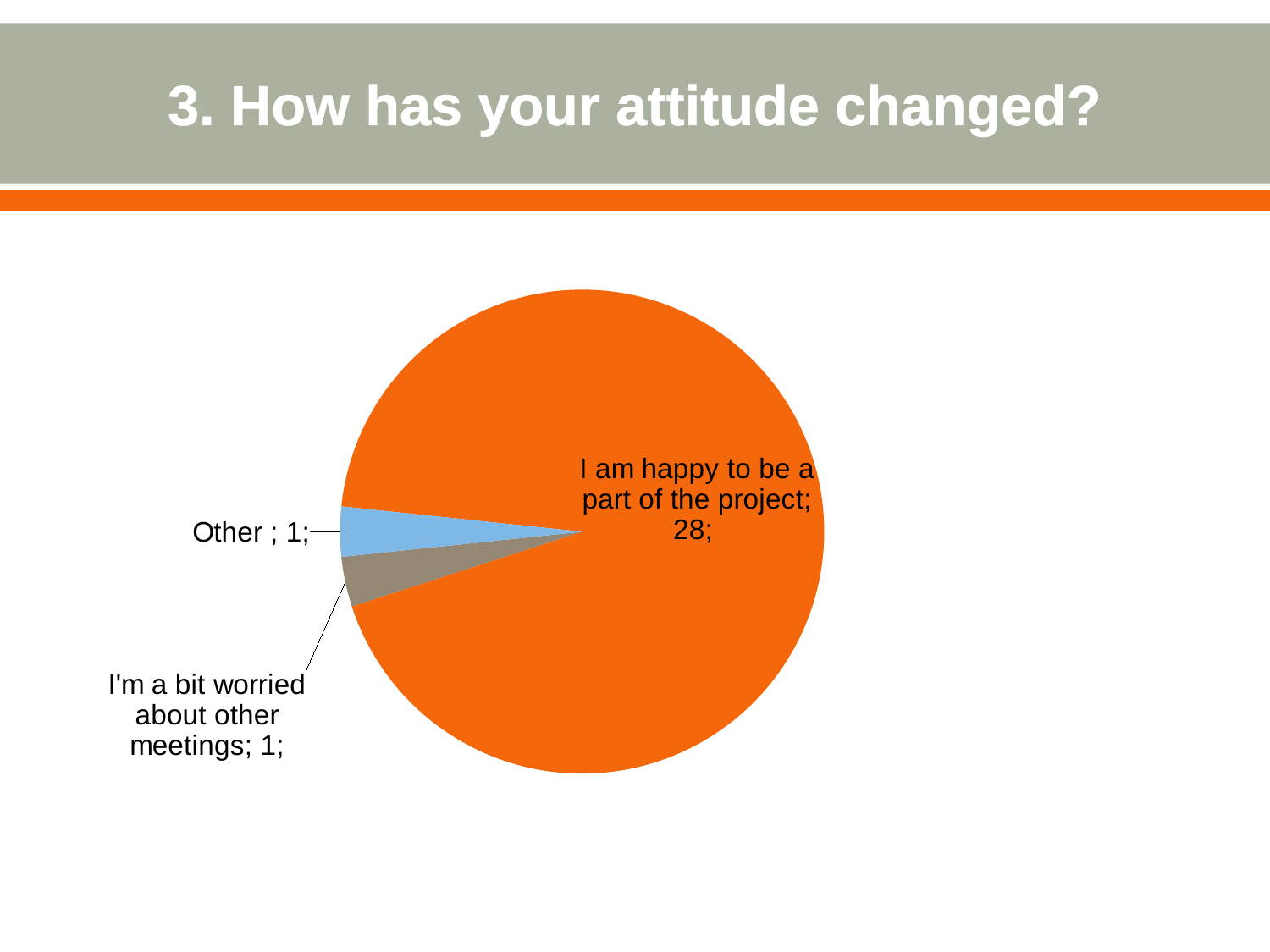
How many slices does the pie chart have? 3 What is the value for "I am happy to be a part of the project"? 28 What is the difference between the value for "I am happy to be a part of the project" and the value for "Other"? 27 What kind of chart is shown on the slide? pie chart What colour is the largest slice of the pie chart? orange Which is larger, the value for "I am happy to be a part of the project" or the value for "Other"? I am happy to be a part of the project Which category has the largest slice of the pie? I am happy to be a part of the project What share of the total responses does "I am happy to be a part of the project" represent? 28 out of 30 What is the value for "Other"? 1 What is the value for "I'm a bit worried about other meetings"? 1 What is the title of the slide containing the chart? 3. How has your attitude changed? What is the total of all the values shown in the pie chart? 30